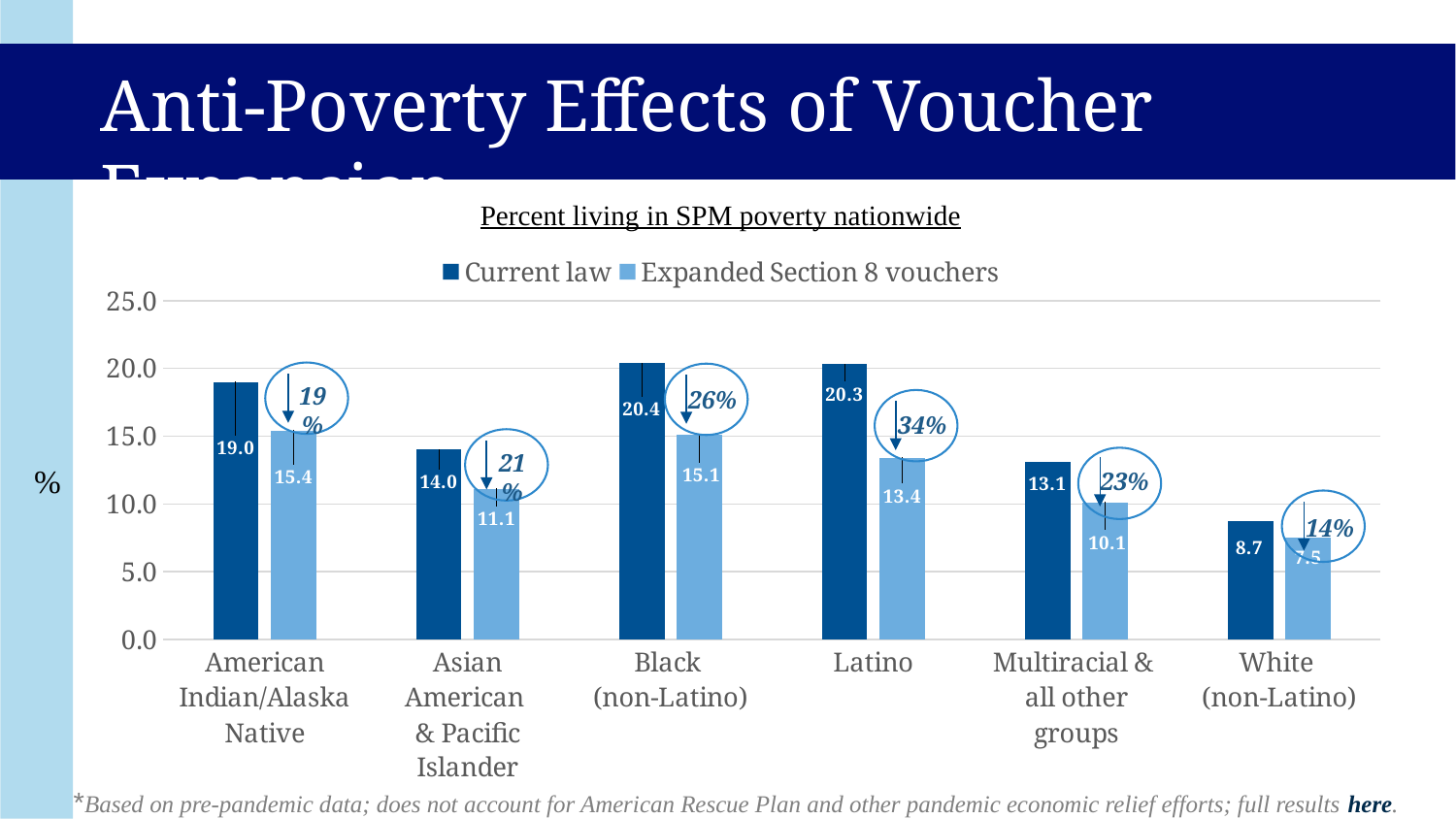
What kind of chart is shown on the slide? bar chart What is the Expanded Section 8 vouchers value for Black (non-Latino)? 15.1 Which category has the lowest Current law value? White (non-Latino) How many series does the legend list? 2 Which is larger: the Current law value for American Indian/Alaska Native or the Current law value for Multiracial & all other groups? American Indian/Alaska Native Which category has the highest Expanded Section 8 vouchers value? American Indian/Alaska Native What is the Current law value for Asian American & Pacific Islander? 14.0 What is the Current law value for Latino? 20.3 How many categories are shown on the x axis? 6 Is the Expanded Section 8 vouchers value for White (non-Latino) greater or less than 10.0? less What is the difference between the Current law and Expanded Section 8 vouchers values for Latino? 6.9 What is the Expanded Section 8 vouchers value for Multiracial & all other groups? 10.1